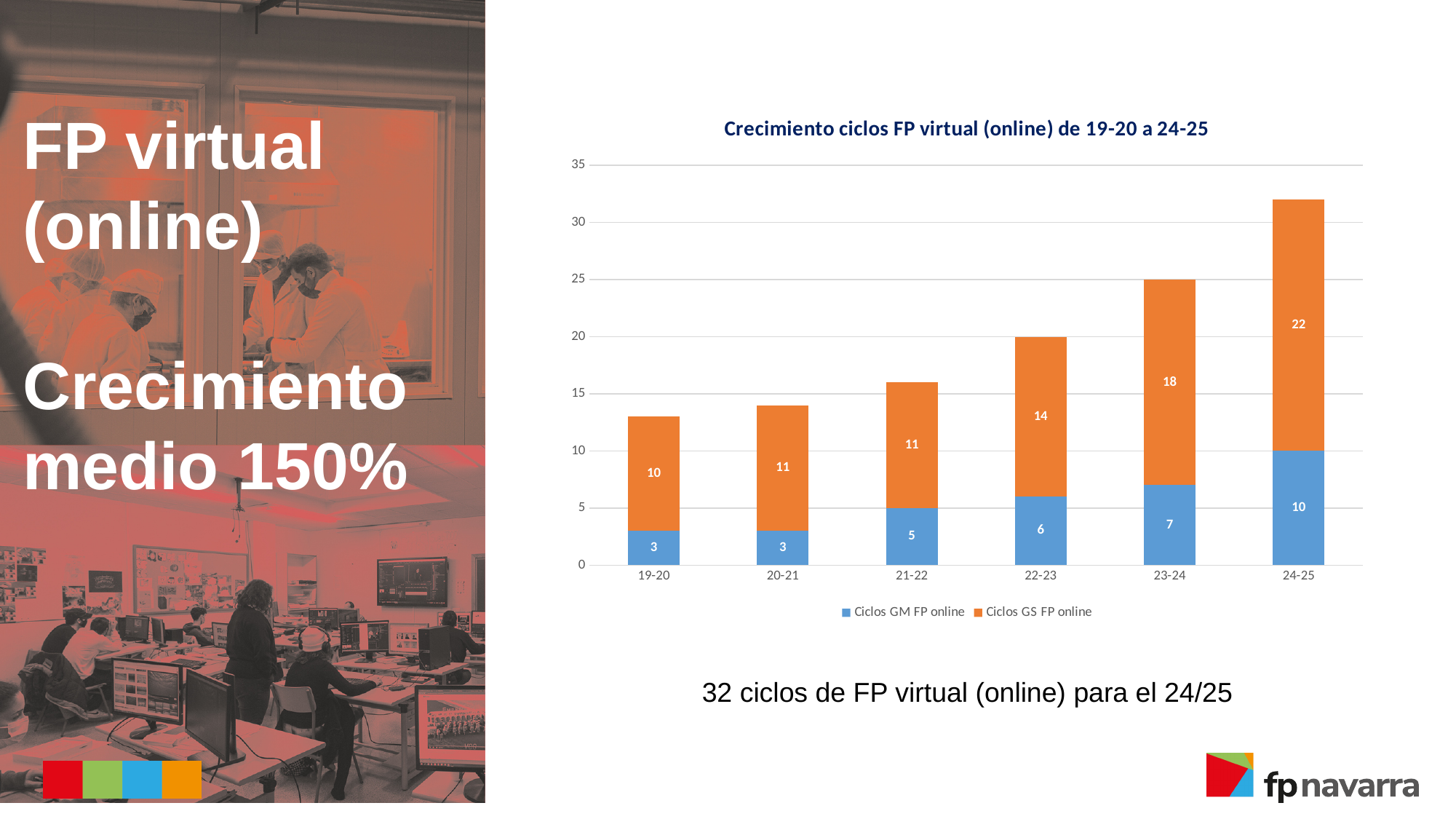
Do the total values rise or fall from 19-20 to 24-25? rise What is the value of Ciclos GS FP online for 22-23? 14 What is the value of Ciclos GM FP online for 21-22? 5 What is the value of Ciclos GS FP online for 24-25? 22 Which academic year has the highest value for Ciclos GM FP online? 24-25 What is the difference between Ciclos GS FP online in 24-25 and in 19-20? 12 What is the total of the stacked bar for 24-25? 32 How many academic years are shown on the x axis? 6 What is the total of the stacked bar for 20-21? 14 Which is larger: Ciclos GM FP online in 23-24 or Ciclos GM FP online in 22-23? Ciclos GM FP online in 23-24 How many series does the legend list? 2 Which academic year has the lowest value for Ciclos GS FP online? 19-20